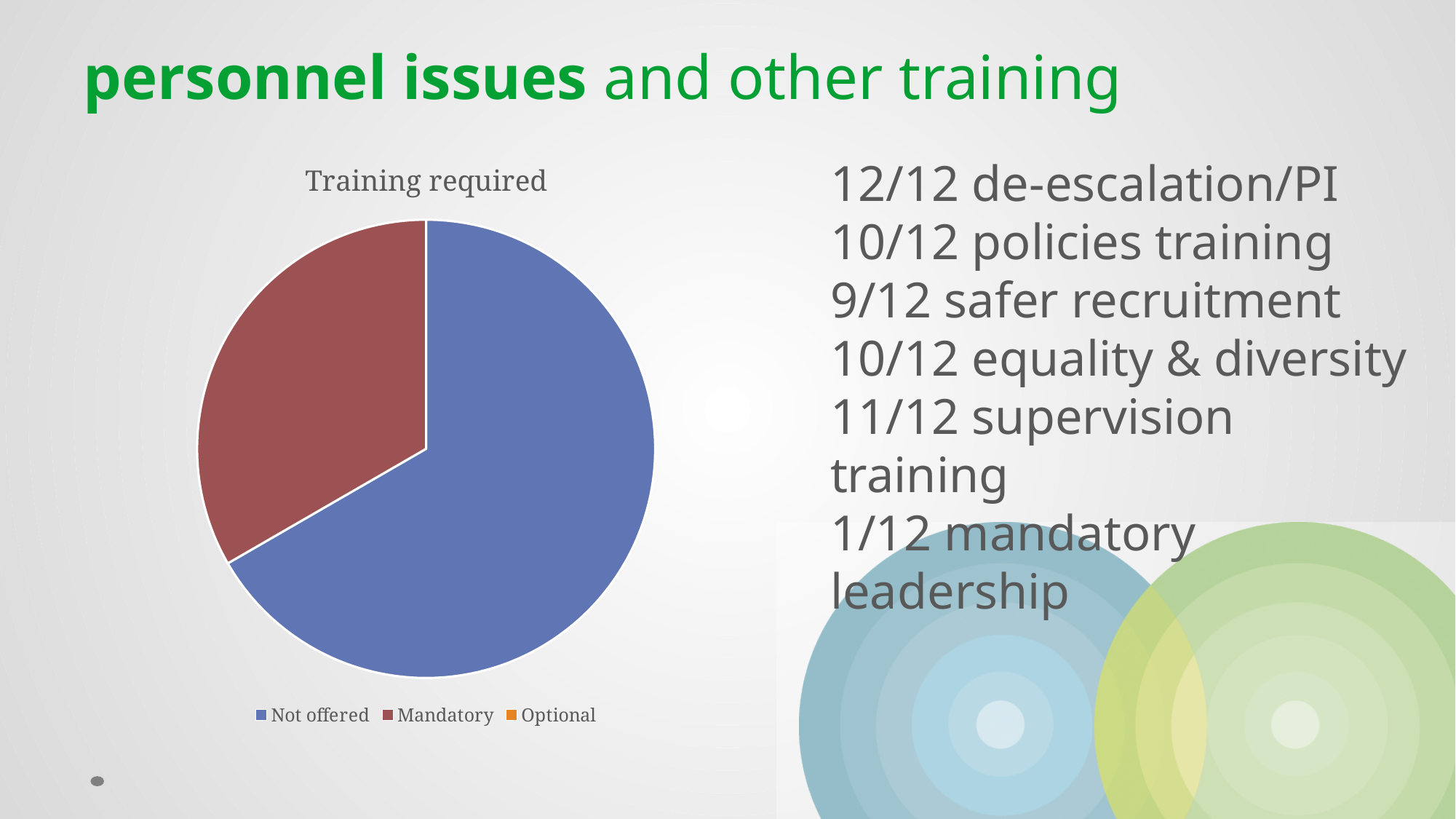
What kind of chart is shown on the slide? pie chart Which category has the largest slice of the pie? Not offered Does the Not offered slice take up more or less than half of the pie? more Which slice is larger, Not offered or Mandatory? Not offered Which colour represents the Mandatory category in the pie chart? red Does the Mandatory slice take up more or less than half of the pie? less How many categories does the chart's legend list? 3 What is the title of the chart? Training required Which legend category has no visible slice in the pie? Optional